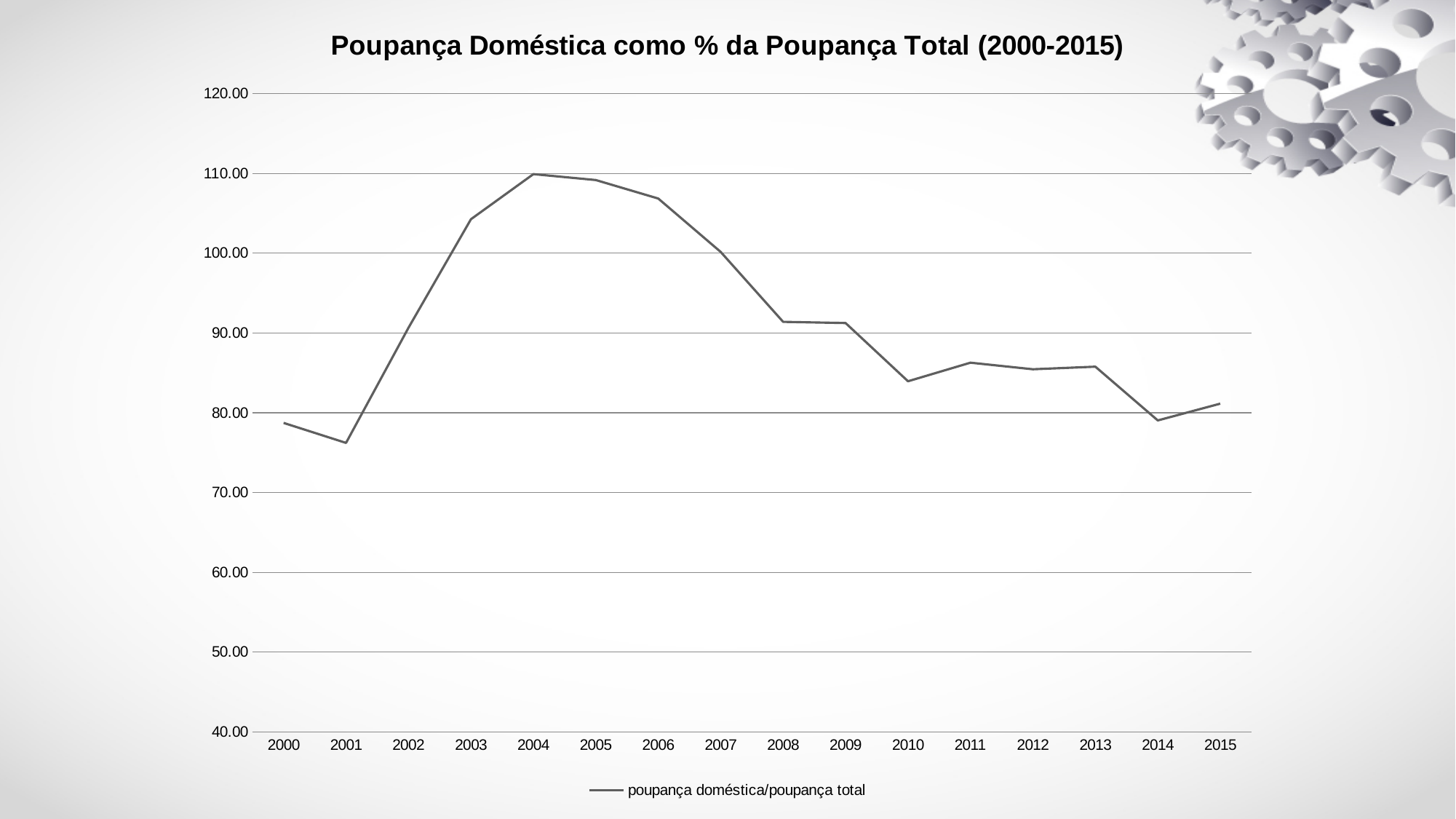
Do the values rise or fall from 2004 to 2010? fall Is the value for 2003 greater or less than 100.00? greater How many series does the legend list? 1 What kind of chart is shown on the slide? line chart How many years are plotted along the x axis? 16 What is the name of the series shown in the legend? poupança doméstica/poupança total In which year is the value of poupança doméstica/poupança total highest? 2004 Is the value for 2001 greater or less than 80.00? less What is the title of the chart? Poupança Doméstica como % da Poupança Total (2000-2015) In which year is the value of poupança doméstica/poupança total lowest? 2001 Which year has the larger value, 2006 or 2008? 2006 Is the value for 2010 greater or less than 90.00? less